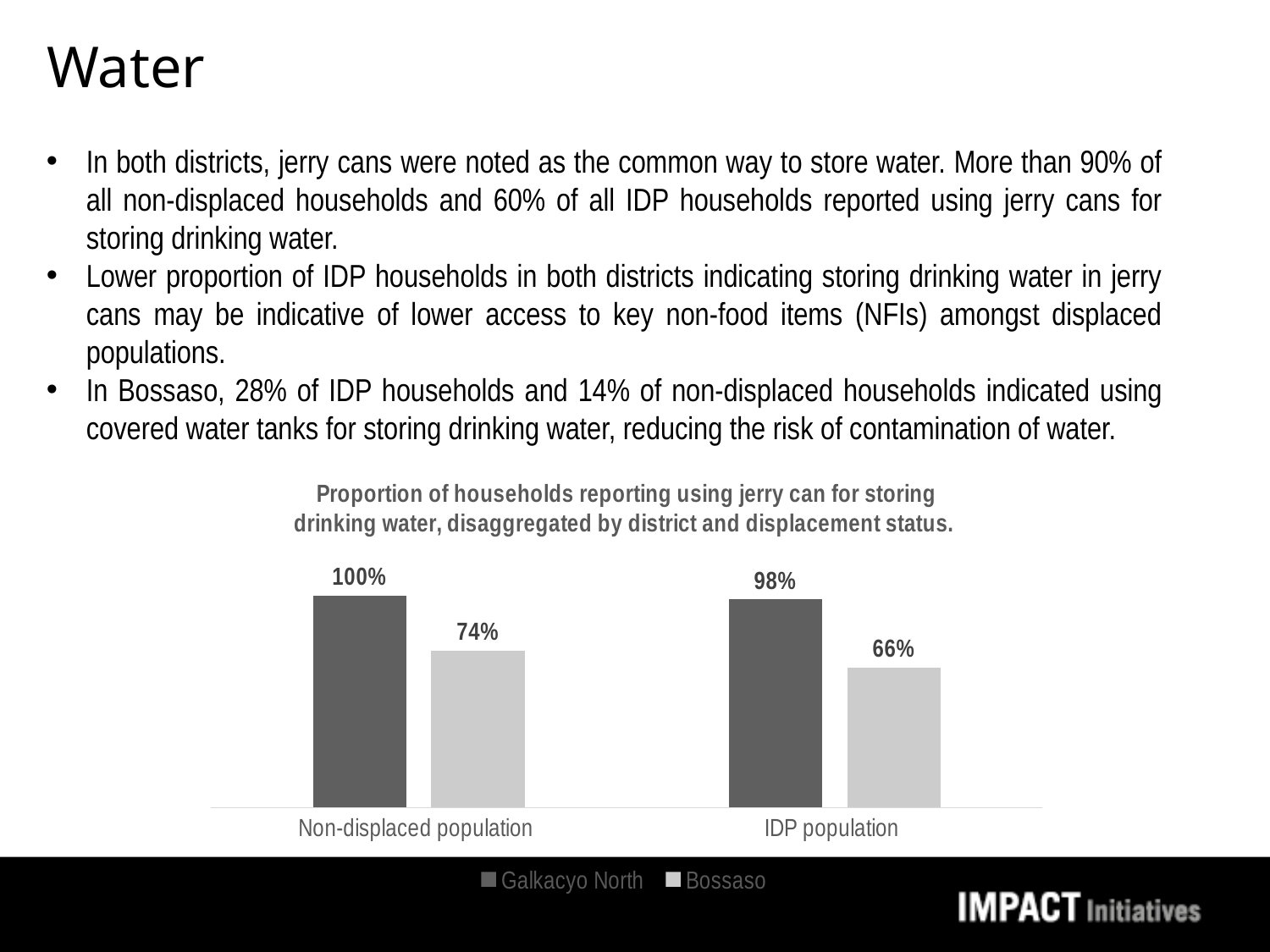
What is the difference between the Galkacyo North and Bossaso values for the Non-displaced population? 26% Which bar in the chart has the highest value? Galkacyo North, Non-displaced population How many series does the chart legend list? 2 Which bar in the chart has the lowest value? Bossaso, IDP population What is the difference between the Galkacyo North and Bossaso values for the IDP population? 32% How many categories are shown on the x axis of the chart? 2 Which is larger: the Bossaso value for the Non-displaced population or the Bossaso value for the IDP population? Non-displaced population What type of chart is shown on the slide? Bar chart What proportion of IDP households in Bossaso reported using jerry cans for storing drinking water? 66% What is the value for Bossaso in the Non-displaced population category? 74% What is the value for Galkacyo North in the IDP population category? 98% What proportion of non-displaced households in Galkacyo North reported using jerry cans for storing drinking water? 100%